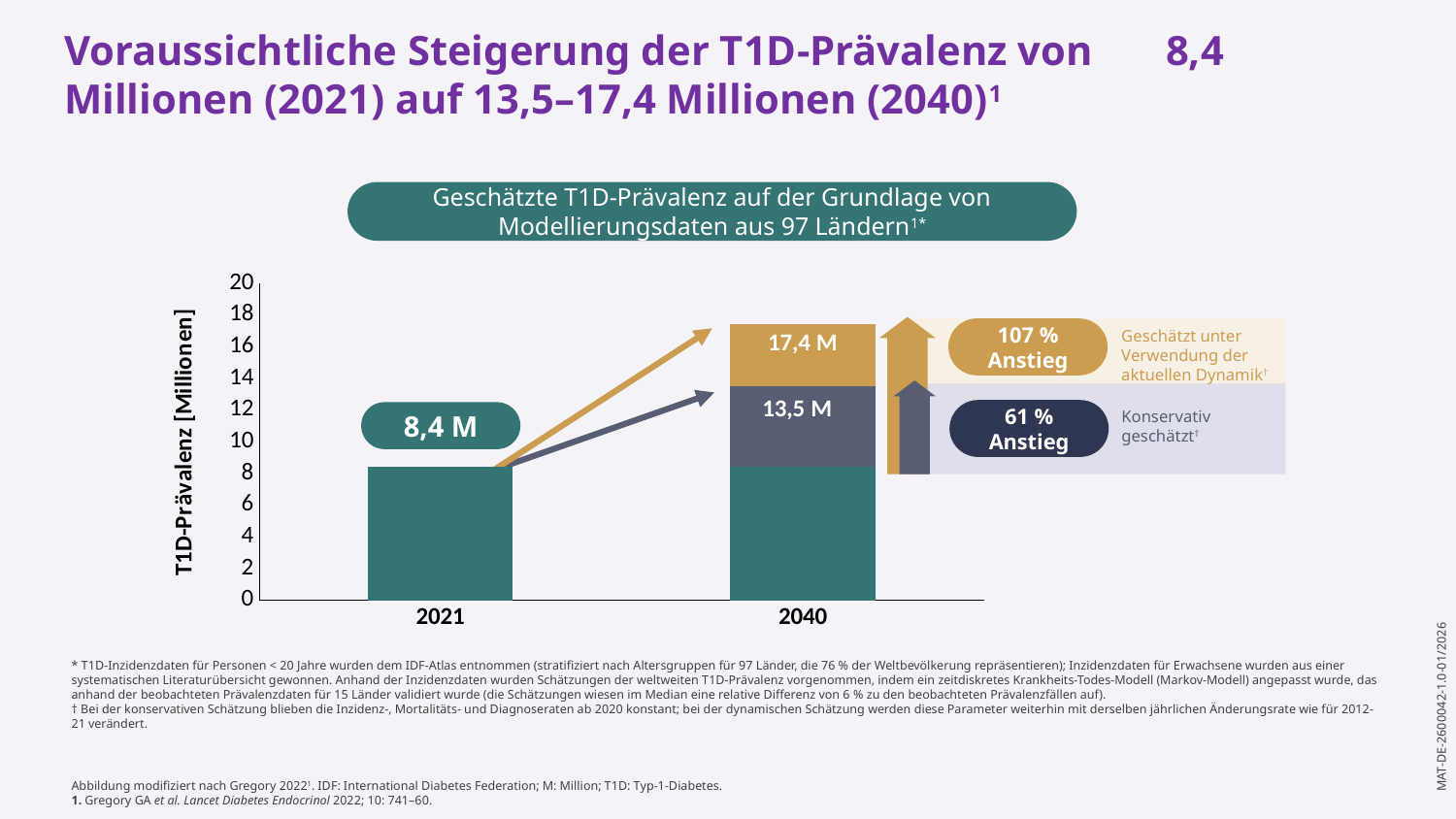
What percentage increase is shown for the estimate using current dynamics? 107 % Anstieg How many years are shown on the x axis? 2 What is the label of the y axis? T1D-Prävalenz [Millionen] What type of chart is shown on the slide? Bar chart What is the estimated T1D prevalence for 2040 using the current dynamics? 17,4 M What is the difference between the conservative 2040 estimate (13,5 M) and the 2021 value (8,4 M)? 5,1 M What is the conservative estimate of T1D prevalence for 2040? 13,5 M What is the difference between the two 2040 estimates, 17,4 M and 13,5 M? 3,9 M What percentage increase is shown for the conservative estimate? 61 % Anstieg Which year has the higher T1D prevalence, 2021 or 2040? 2040 What is the difference between the 2040 estimate using current dynamics (17,4 M) and the 2021 value (8,4 M)? 9,0 M What is the T1D prevalence shown for 2021? 8,4 M